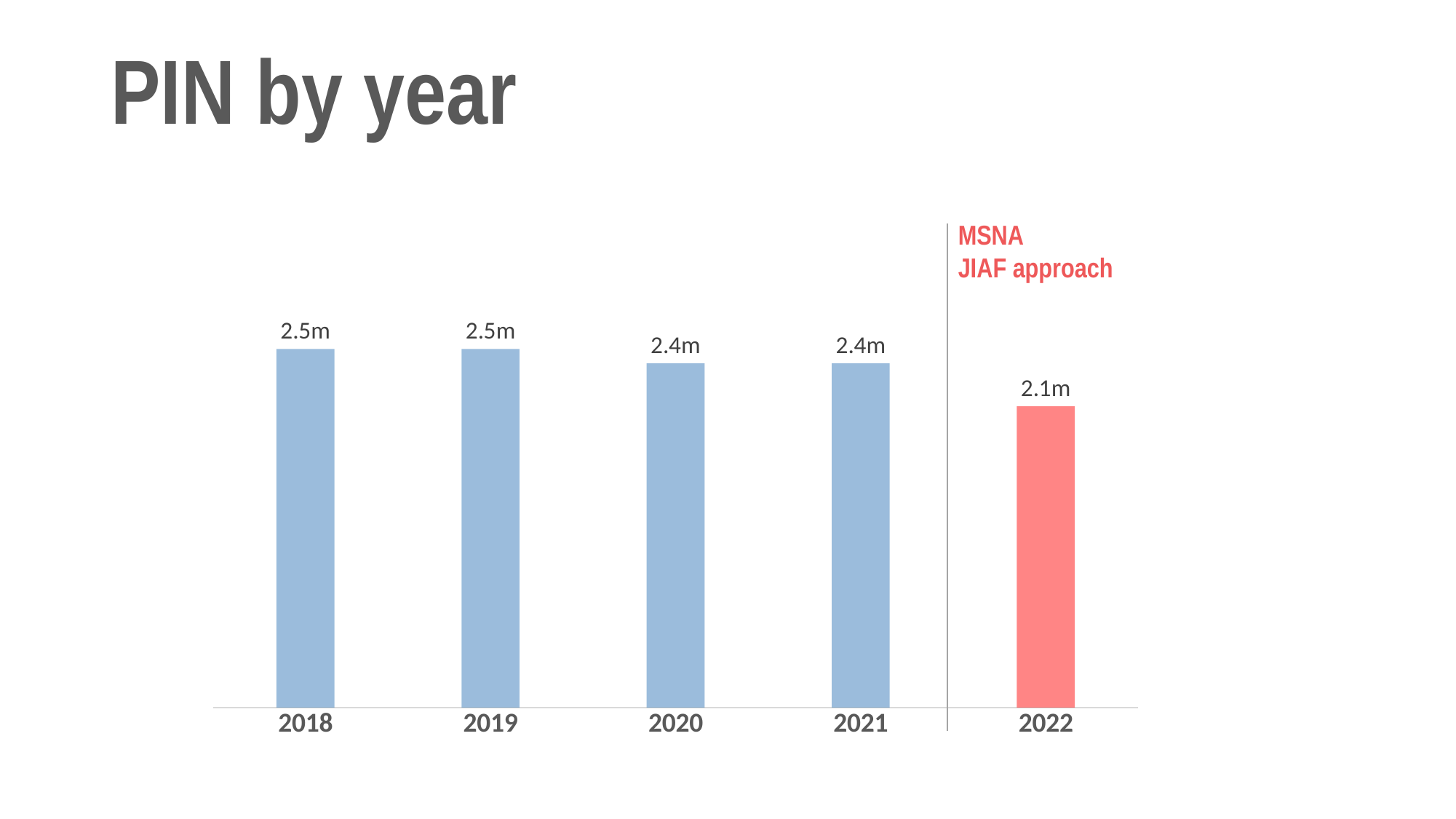
What is the PIN value for 2018? 2.5m What is the PIN value for 2022? 2.1m What kind of chart is shown on the slide? Bar chart How many years are shown on the chart? 5 Which is larger, the PIN value for 2021 or the PIN value for 2022? 2021 What is the difference between the PIN value for 2019 and the PIN value for 2022? 0.4m What is the PIN value for 2020? 2.4m What is the difference between the PIN value for 2018 and the PIN value for 2020? 0.1m What is the title of the chart? PIN by year What is the PIN value for 2021? 2.4m Which year has the lowest PIN value? 2022 Do the PIN values rise or fall from 2018 to 2022? Fall